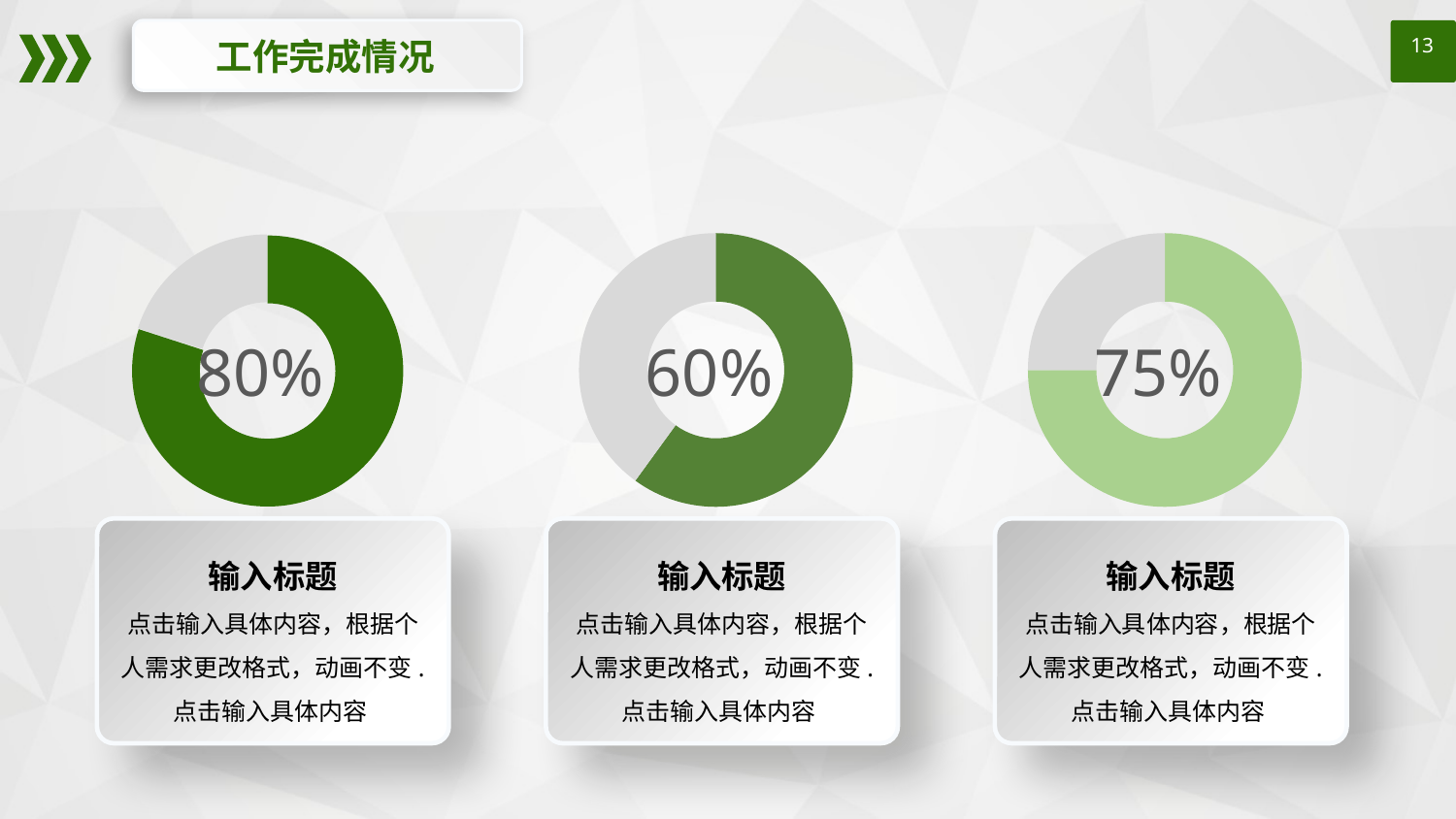
What is the difference between the percentage in the right donut chart and the percentage in the middle donut chart? 15% How many donut charts are on the slide? 3 Which of the three donut charts shows the highest percentage? The left chart (80%) What percentage is shown in the centre of the right donut chart? 75% What percentage is shown in the centre of the left donut chart? 80% What colour is the filled portion of the right donut chart? Light green What percentage is shown in the centre of the middle donut chart? 60% What kind of chart is used three times on this slide? Donut (ring) chart What is the title of the slide containing the three donut charts? 工作完成情况 Which is larger, the percentage in the right donut chart or the percentage in the middle donut chart? The right chart (75%) Which of the three donut charts shows the lowest percentage? The middle chart (60%) What is the difference between the percentage in the left donut chart and the percentage in the middle donut chart? 20%